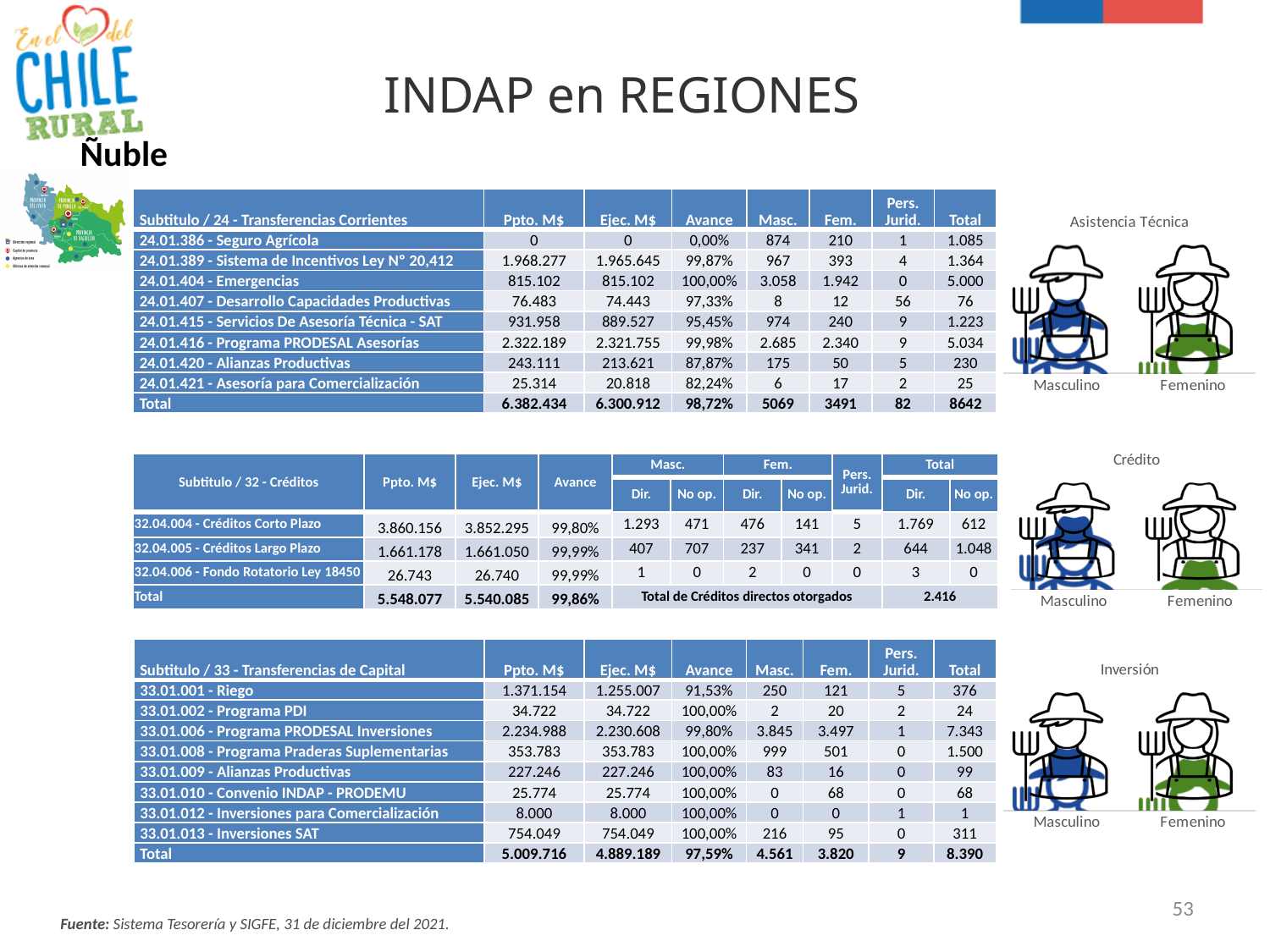
How many pictogram charts are shown on the right side of the slide? 3 What kind of chart is used to show Asistencia Técnica on the right of the slide? pictogram (icon chart) In the pictogram charts, what colour is used for the Masculino fill and what colour for the Femenino fill? blue for Masculino, green for Femenino In the Inversión pictogram, which figure is filled higher, Masculino or Femenino? Masculino In the Crédito pictogram, which figure is filled higher, Masculino or Femenino? Masculino How many categories does each pictogram chart show? 2 What are the titles of the three pictogram charts on the slide? Asistencia Técnica, Crédito, Inversión In the Asistencia Técnica pictogram, which figure is filled higher, Masculino or Femenino? Masculino